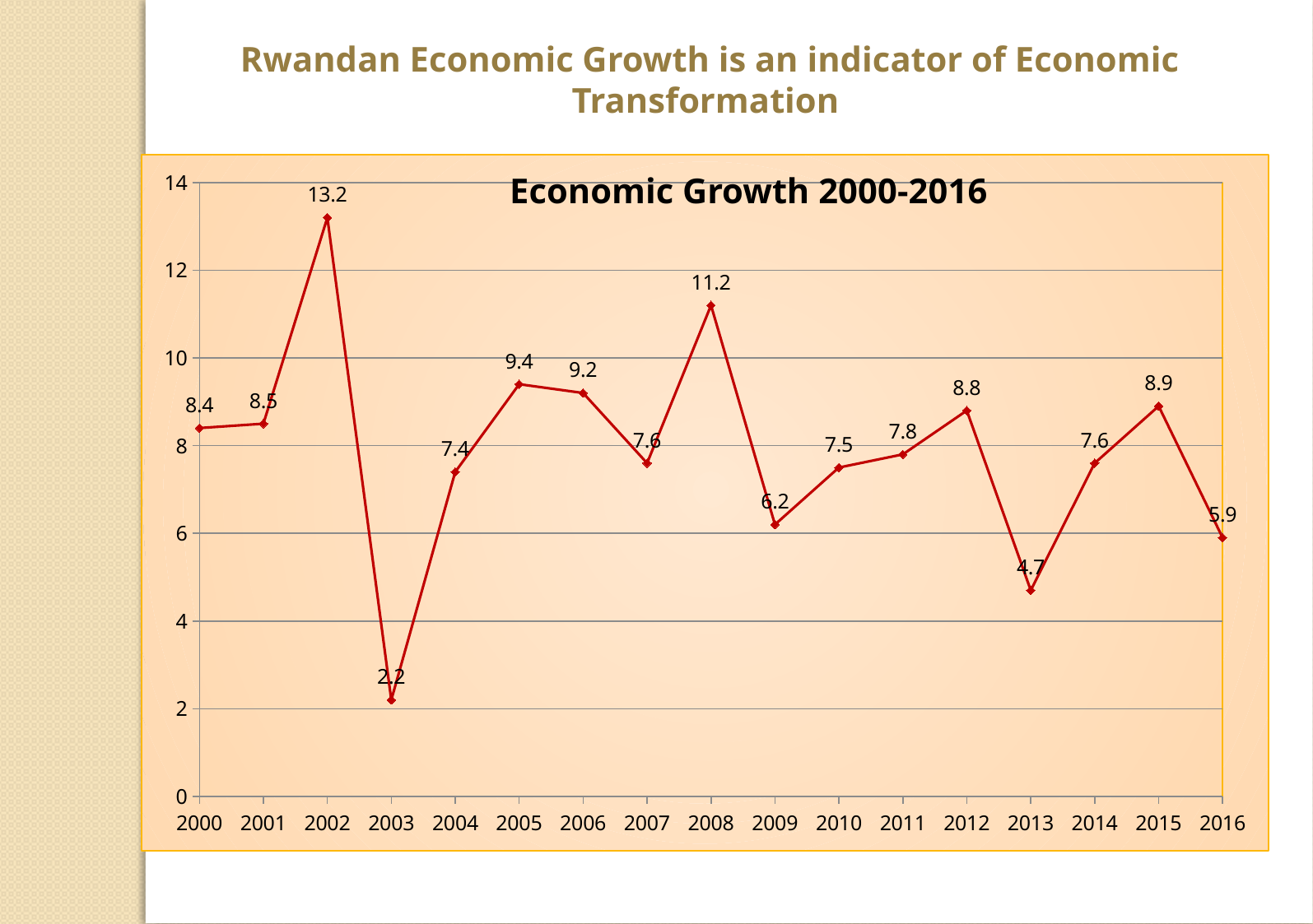
How many years are plotted on the chart? 17 What is the economic growth value for 2013? 4.7 What kind of chart is shown on the slide? line chart What is the economic growth value for 2016? 5.9 Which year has a higher economic growth value, 2005 or 2012? 2005 Which year has the lowest economic growth value? 2003 What is the difference between the economic growth values for 2002 and 2003? 11 What is the difference between the economic growth values for 2008 and 2009? 5 Is the economic growth value for 2008 greater or less than 10? greater What is the economic growth value for 2002? 13.2 Which year has the highest economic growth value? 2002 What is the title of the chart? Economic Growth 2000-2016